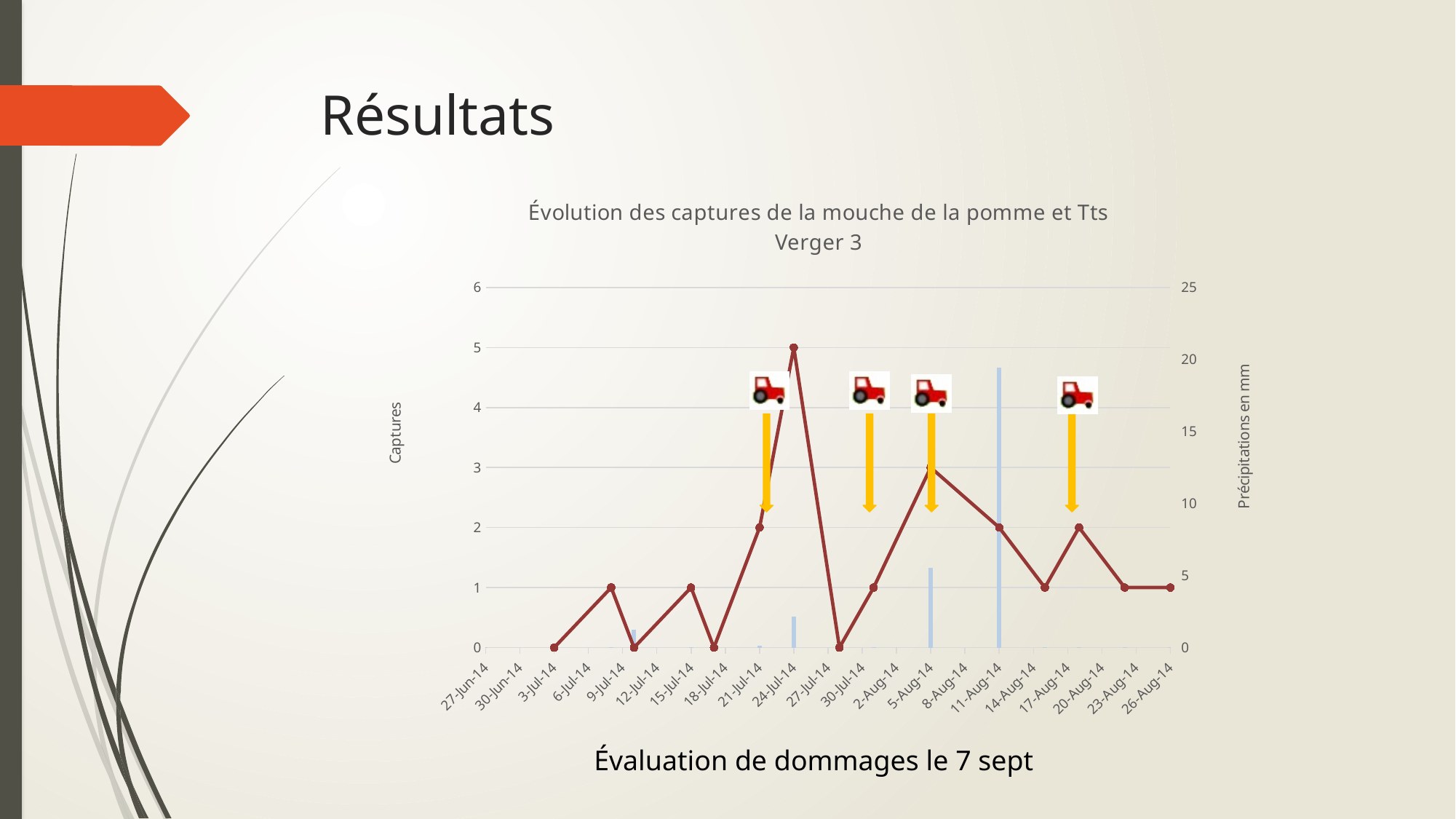
What is the title of the chart? Évolution des captures de la mouche de la pomme et Tts Verger 3 On which date is the number of captures highest? 24-Jul-14 What is the number of captures on 5-Aug-14? 3 Is the precipitation value on 11-Aug-14 greater or less than 15? greater What is the number of captures on 24-Jul-14? 5 What is the difference in captures between 24-Jul-14 and 5-Aug-14? 2 Do the captures rise or fall between 24-Jul-14 and 27-Jul-14? fall What is the label of the left vertical axis? Captures Which date has more captures, 17-Aug-14 or 14-Aug-14? 17-Aug-14 How many tractor icons are shown above the chart line? 4 What is the number of captures on 21-Jul-14? 2 Is the precipitation value on 5-Aug-14 greater or less than 10? less